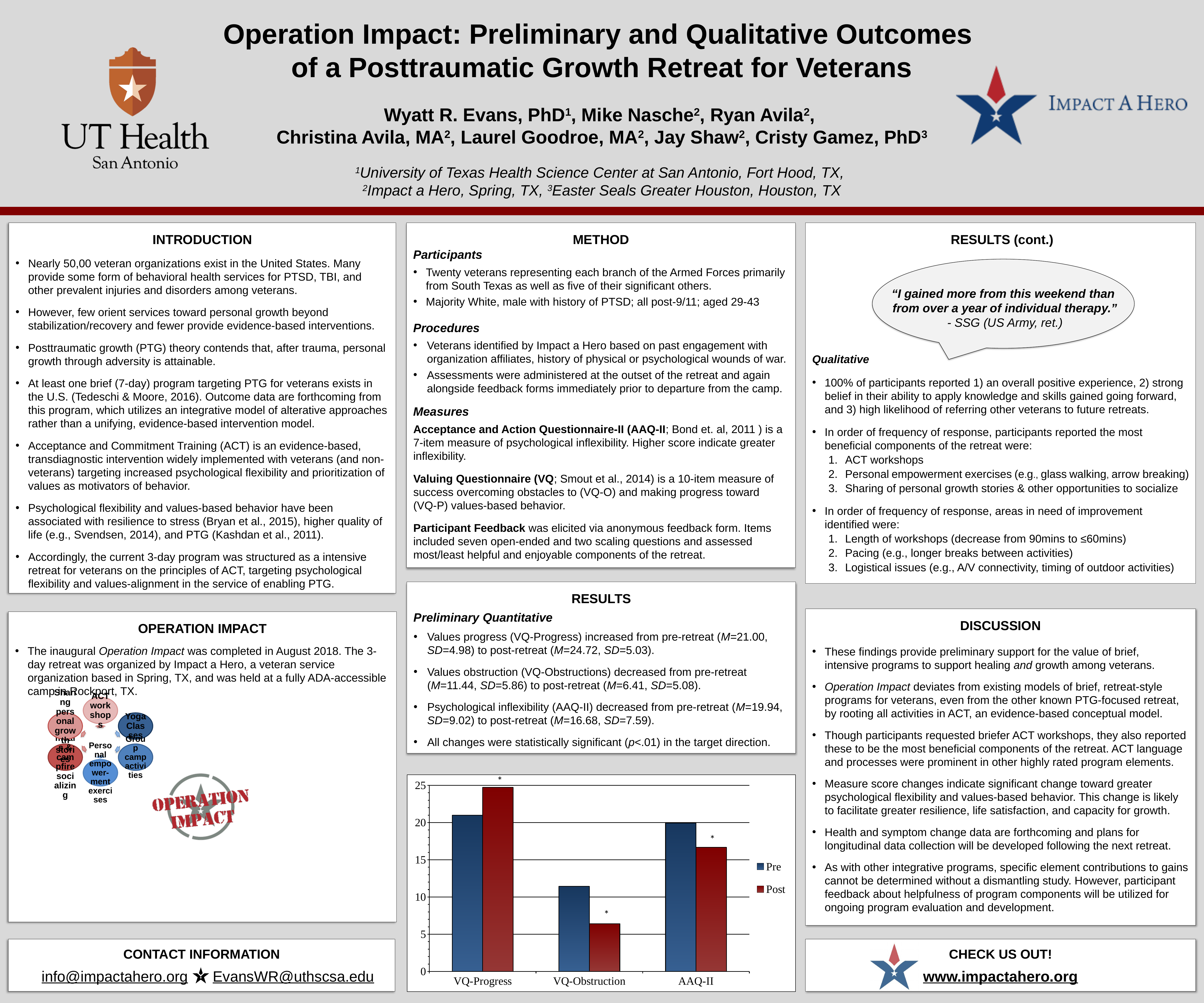
In the bar chart, which colour represents the Post series? red What kind of chart is shown at the bottom of the middle column? bar chart Which bar in the bar chart is the shortest overall? Post for VQ-Obstruction Which bar in the bar chart is the tallest overall? Post for VQ-Progress What are the two series named in the legend of the bar chart? Pre and Post How many series does the legend of the bar chart list? 2 In the bar chart, is the Post value for VQ-Obstruction greater or less than 10? less In the bar chart, is the Post value for AAQ-II greater or less than 15? greater In the bar chart, is the Pre or the Post bar larger for VQ-Obstruction? Pre In the bar chart, is the Pre or the Post bar larger for AAQ-II? Pre In the bar chart, is the Pre or the Post bar larger for VQ-Progress? Post How many categories are shown on the x axis of the bar chart? 3